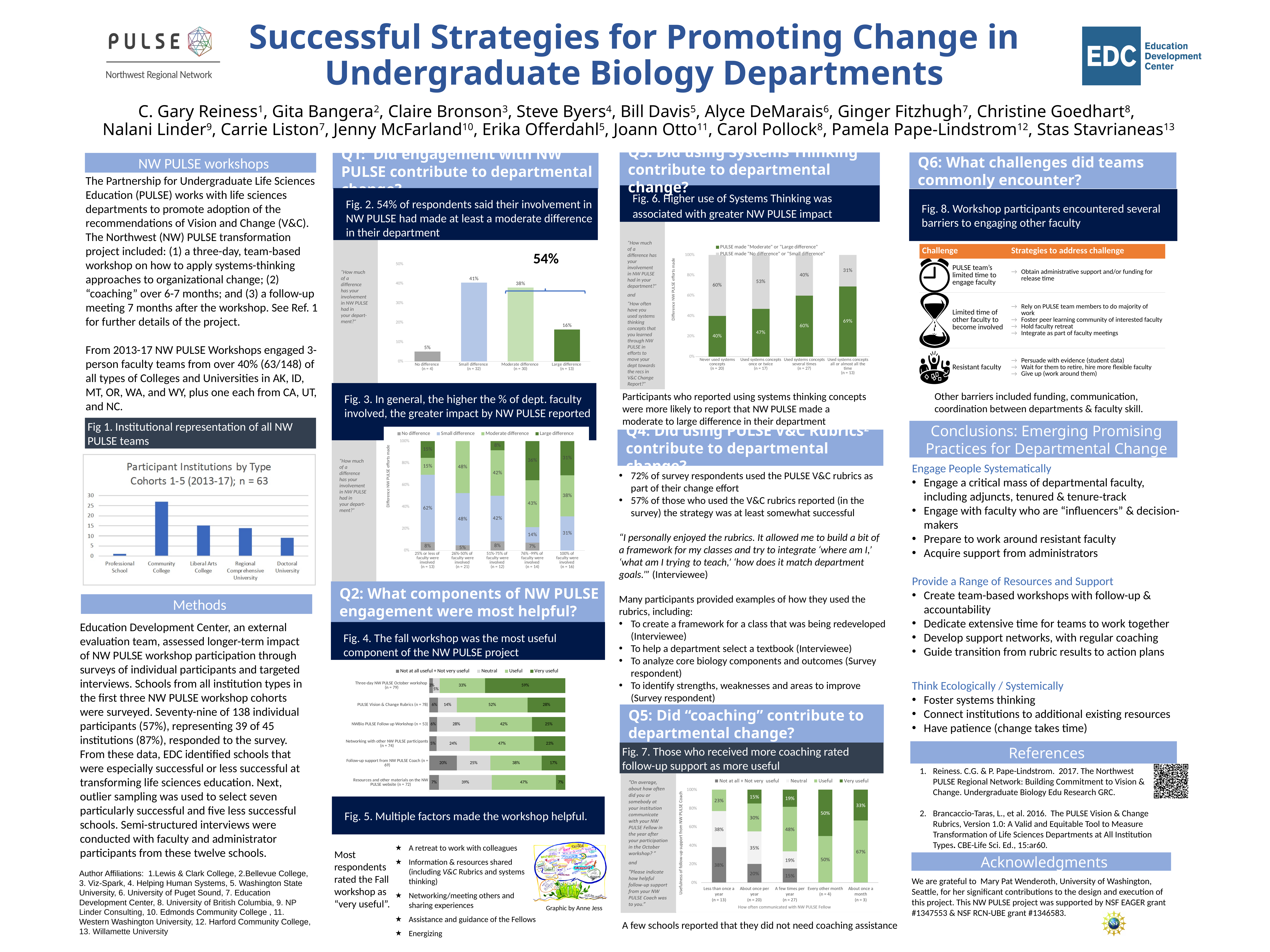
In Fig. 7 (Q5 chart), what percentage of those communicating 'About once a month' rated follow-up support as 'Useful'? 67% In Fig. 2 (Q1 chart), what is the difference in percentage points between 'Moderate difference' and 'Large difference'? 22 In Fig. 1 (Participant Institutions by Type), what kind of chart is used? Bar chart In Fig. 6 (Q3 chart), how many series does the legend list? 2 In Fig. 4 (Q2 chart), what percentage rated the Three-day NW PULSE October workshop as 'Very useful'? 59% In Fig. 3 (Q1 stacked chart), how many series does the legend list? 4 In Fig. 2 (Q1 chart), how many response categories are shown on the x axis? 4 In Fig. 6 (Q3 chart), what percentage of those who 'Never used systems concepts' said PULSE made a 'Moderate' or 'Large difference'? 40% In Fig. 1 (Participant Institutions by Type), is the value for Doctoral University greater or less than 10? less In Fig. 2 (Q1 chart), which response category has the lowest percentage? No difference In Fig. 2 (Q1 chart), what percentage of respondents reported a 'Small difference'? 41% In Fig. 1 (Participant Institutions by Type), which institution type has the highest count? Community College